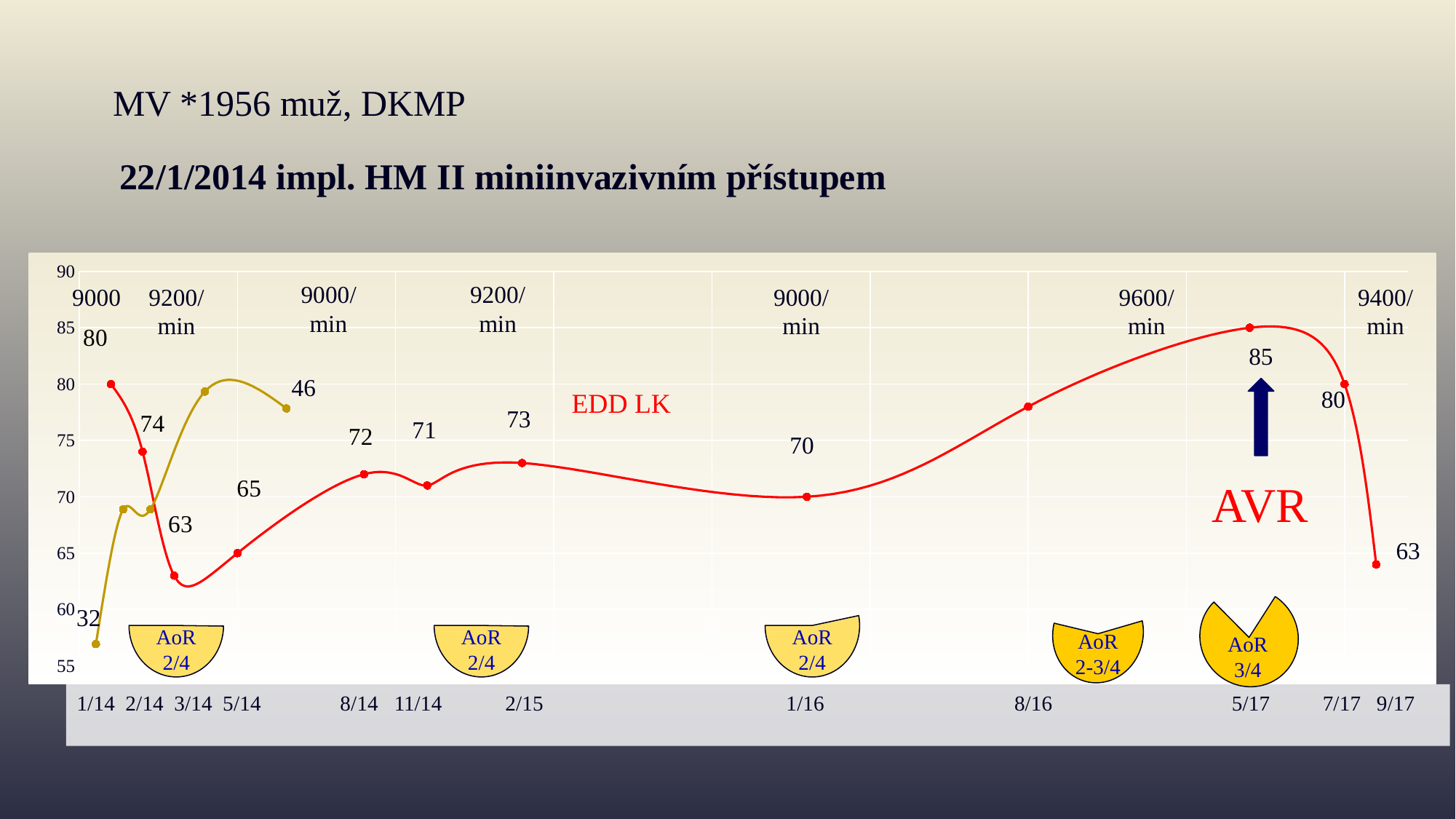
What is the difference between the EDD LK values at 5/17 and 7/17? 5 At which date does the EDD LK line reach its highest value? 5/17 What is the difference between the EDD LK values at 1/14 and 3/14? 17 Does the EDD LK line rise or fall between 1/16 and 5/17? rise What is the EDD LK value at 1/14? 80 What is the lowest labelled value on the EDD LK line? 63 What is the EDD LK value at 5/17? 85 Which is larger, the EDD LK value at 2/15 or at 1/16? 2/15 What is the EDD LK value at 3/14? 63 What kind of chart is shown on the slide? line chart What is the EDD LK value at 1/16? 70 Is the EDD LK value at 8/16 greater or less than 75? greater